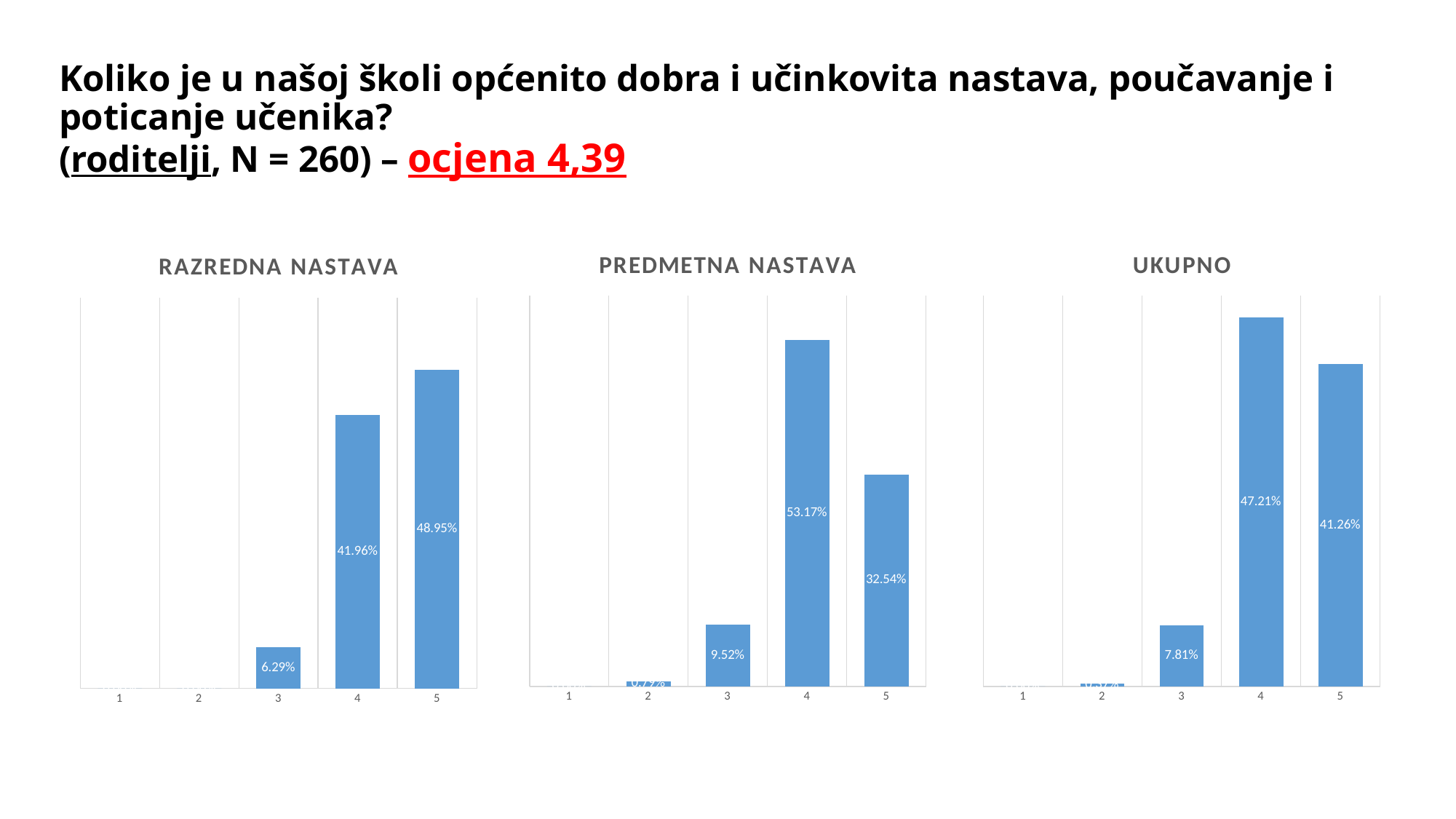
In the UKUPNO chart, what is the value for category 5? 41.26% What kind of chart is the RAZREDNA NASTAVA chart? bar chart In the RAZREDNA NASTAVA chart, which category has the highest value? 5 In the UKUPNO chart, what is the difference between the values for category 4 and category 3? 39.40% In the PREDMETNA NASTAVA chart, what is the value for category 3? 9.52% In the RAZREDNA NASTAVA chart, what is the value for category 5? 48.95% How many categories are shown on the x axis of the UKUPNO chart? 5 In the PREDMETNA NASTAVA chart, what is the difference between the values for category 4 and category 5? 20.63% In the PREDMETNA NASTAVA chart, what is the value for category 4? 53.17% In the UKUPNO chart, which category has the highest value? 4 In the PREDMETNA NASTAVA chart, which is larger, the value for category 3 or the value for category 5? category 5 In the RAZREDNA NASTAVA chart, what is the value for category 4? 41.96%